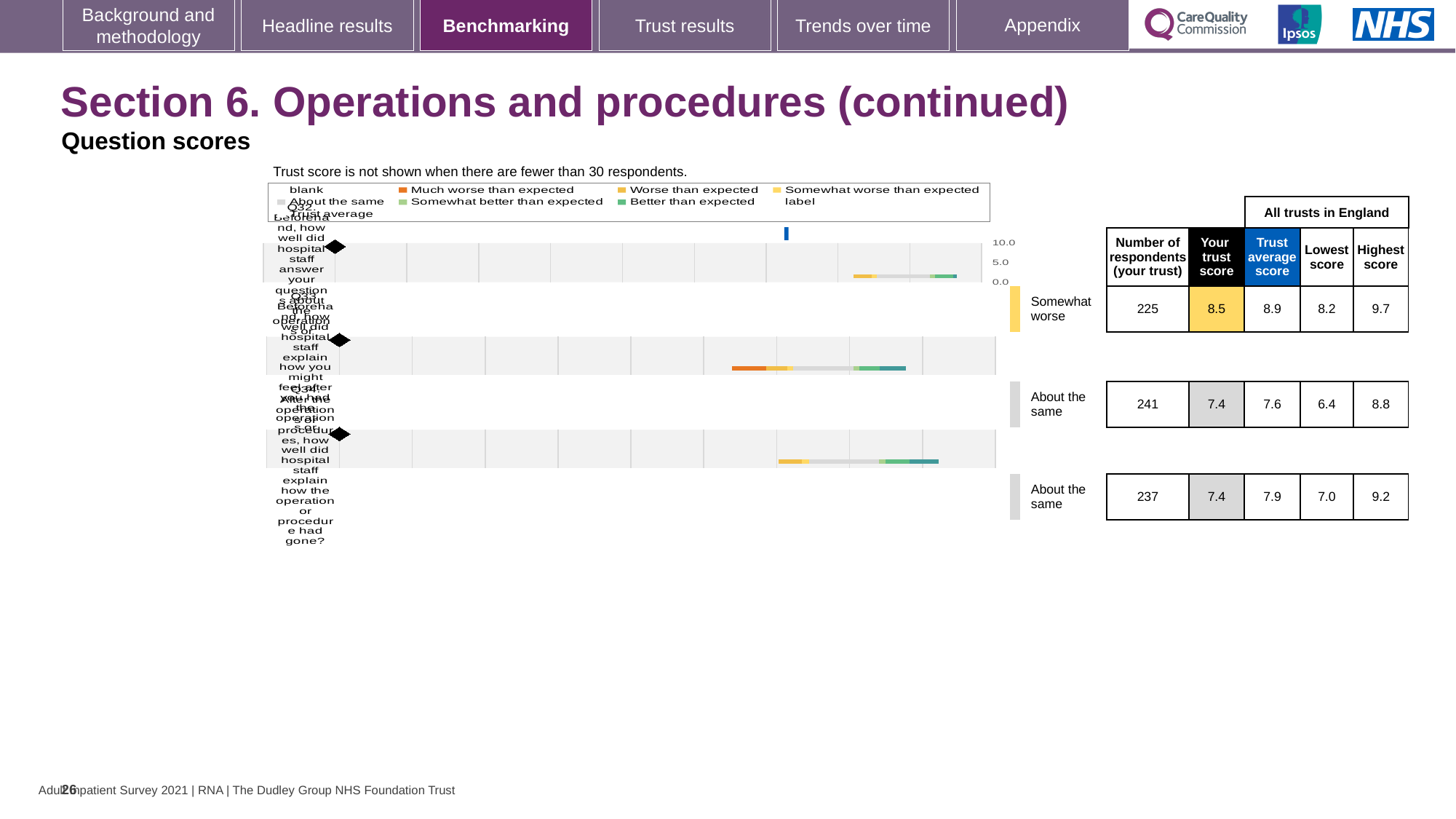
Which question row has the highest trust score? the first (top) row What is the lowest score across all trusts in England for the second question row? 6.4 What is the trust score for the first (top) question row? 8.5 What kind of chart is shown on the slide? bar chart What is the highest score across all trusts in England for the third (bottom) question row? 9.2 Which question row has the most respondents? the second row What benchmark category is shown for the first (top) question row? Somewhat worse How many question rows are plotted in the chart? 3 What is the difference between the trust average score and the trust score for the first (top) question row? 0.4 What is the trust average score for the second question row? 7.6 What is the number of respondents for the first (top) question row? 225 Is the trust score for the third (bottom) question row larger or smaller than its trust average score? smaller